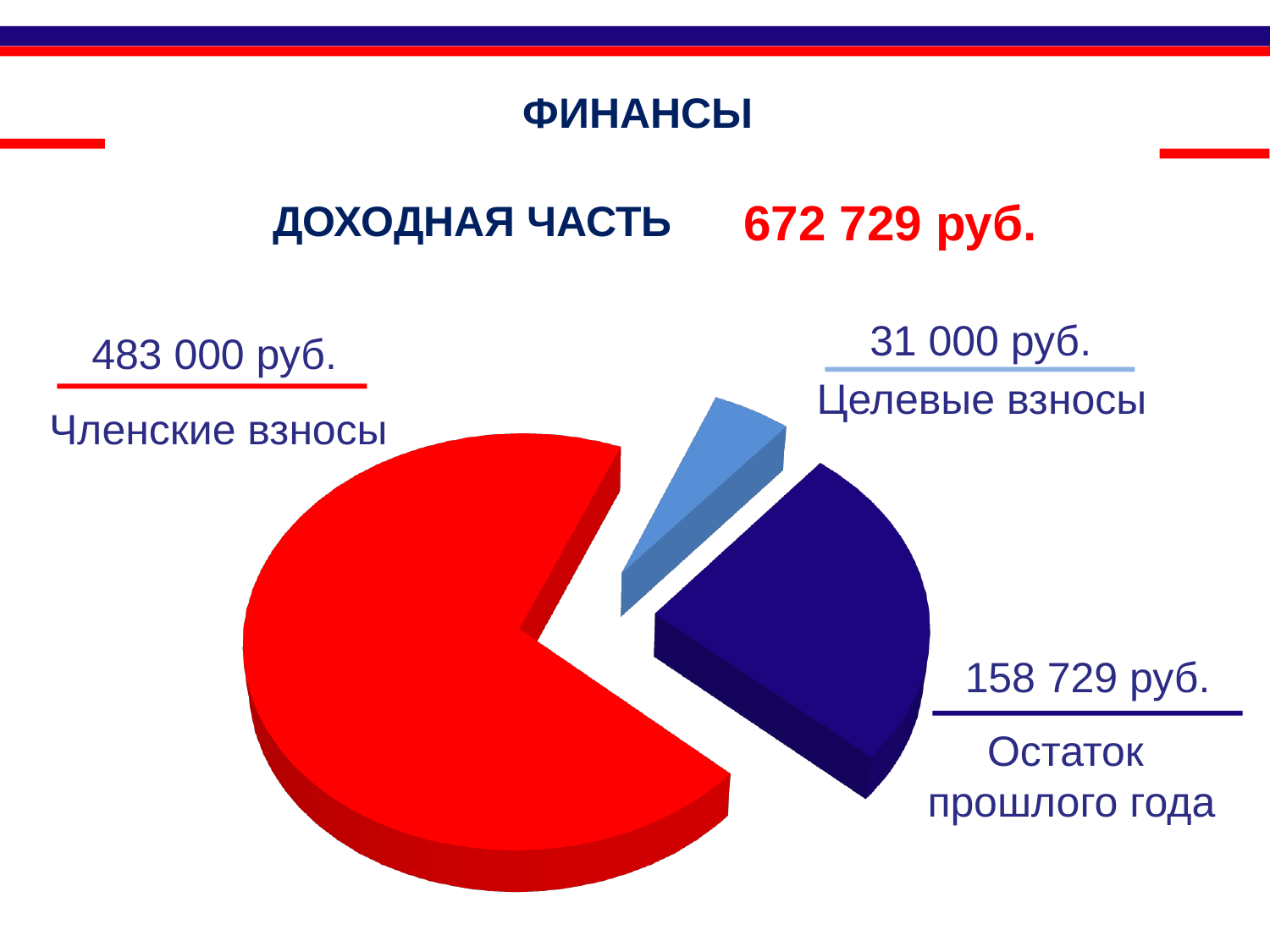
What colour is the slice for Членские взносы? Red How many slices does the pie chart have? 3 What is the value for Целевые взносы on the pie chart? 31 000 руб. What kind of chart is shown on the slide? Pie chart What is the value for Членские взносы on the pie chart? 483 000 руб. What is the difference between Остаток прошлого года and Целевые взносы? 127 729 руб. What is the value for Остаток прошлого года on the pie chart? 158 729 руб. What is the difference between Членские взносы and Остаток прошлого года? 324 271 руб. Which category has the largest slice of the pie chart? Членские взносы Which is larger, Остаток прошлого года or Целевые взносы? Остаток прошлого года Which category has the smallest slice of the pie chart? Целевые взносы What is the total of the income (ДОХОДНАЯ ЧАСТЬ) shown on the slide? 672 729 руб.